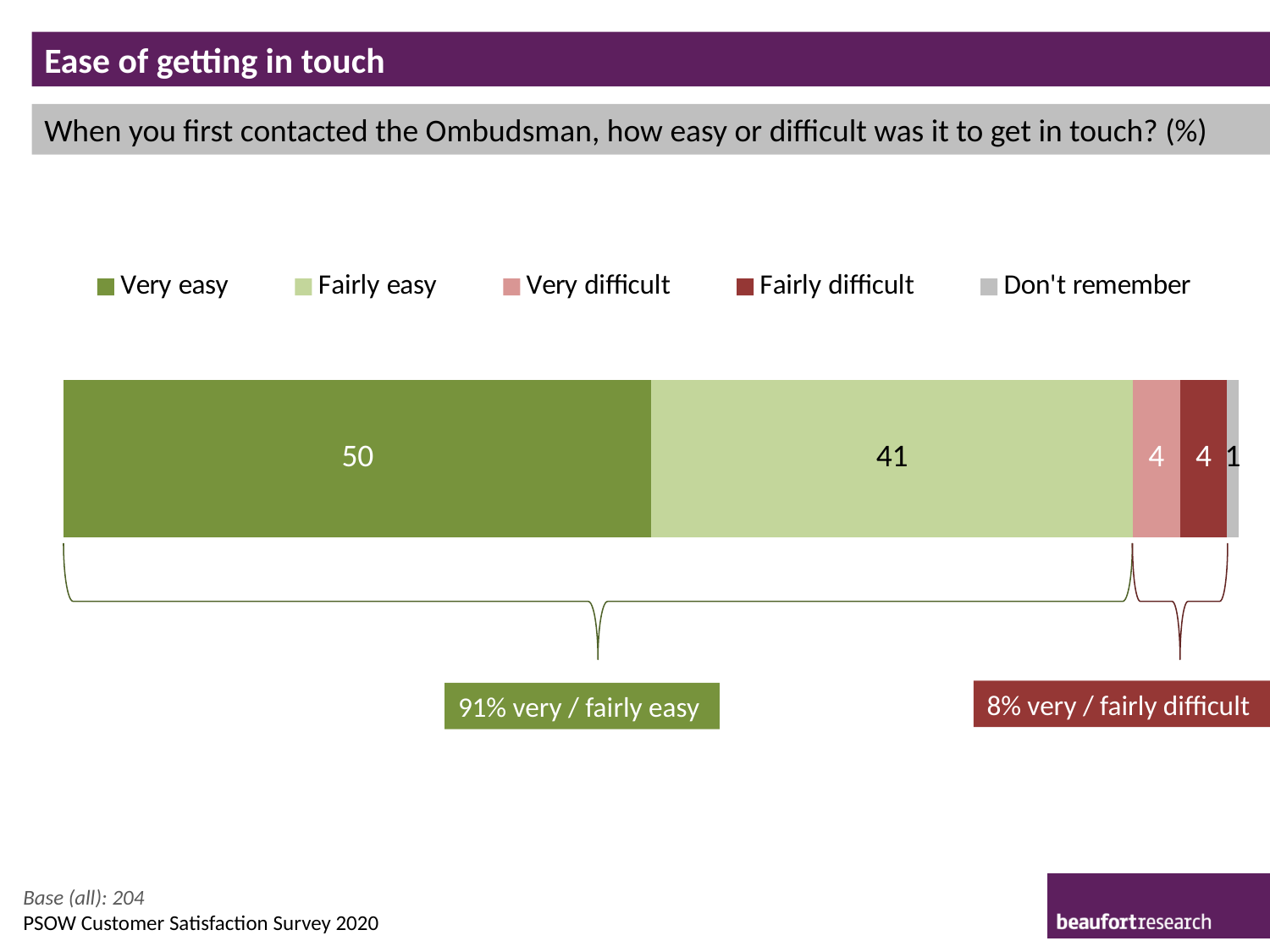
What value is shown for the Don't remember segment? 1 What value is shown for the Very difficult segment? 4 Which response category has the largest share? Very easy What is the total of all segments in the stacked bar? 100 Which response category has the smallest share? Don't remember What is the difference between the Very easy and Fairly easy values? 9 According to the callout below the bar, what combined percentage said it was very or fairly easy? 91% How many series does the legend list? 5 What percentage of respondents said it was very easy to get in touch? 50 What kind of chart is shown on the slide? Stacked bar chart Which is larger, the Very easy value or the Fairly easy value? Very easy What value is shown for the Fairly easy segment? 41